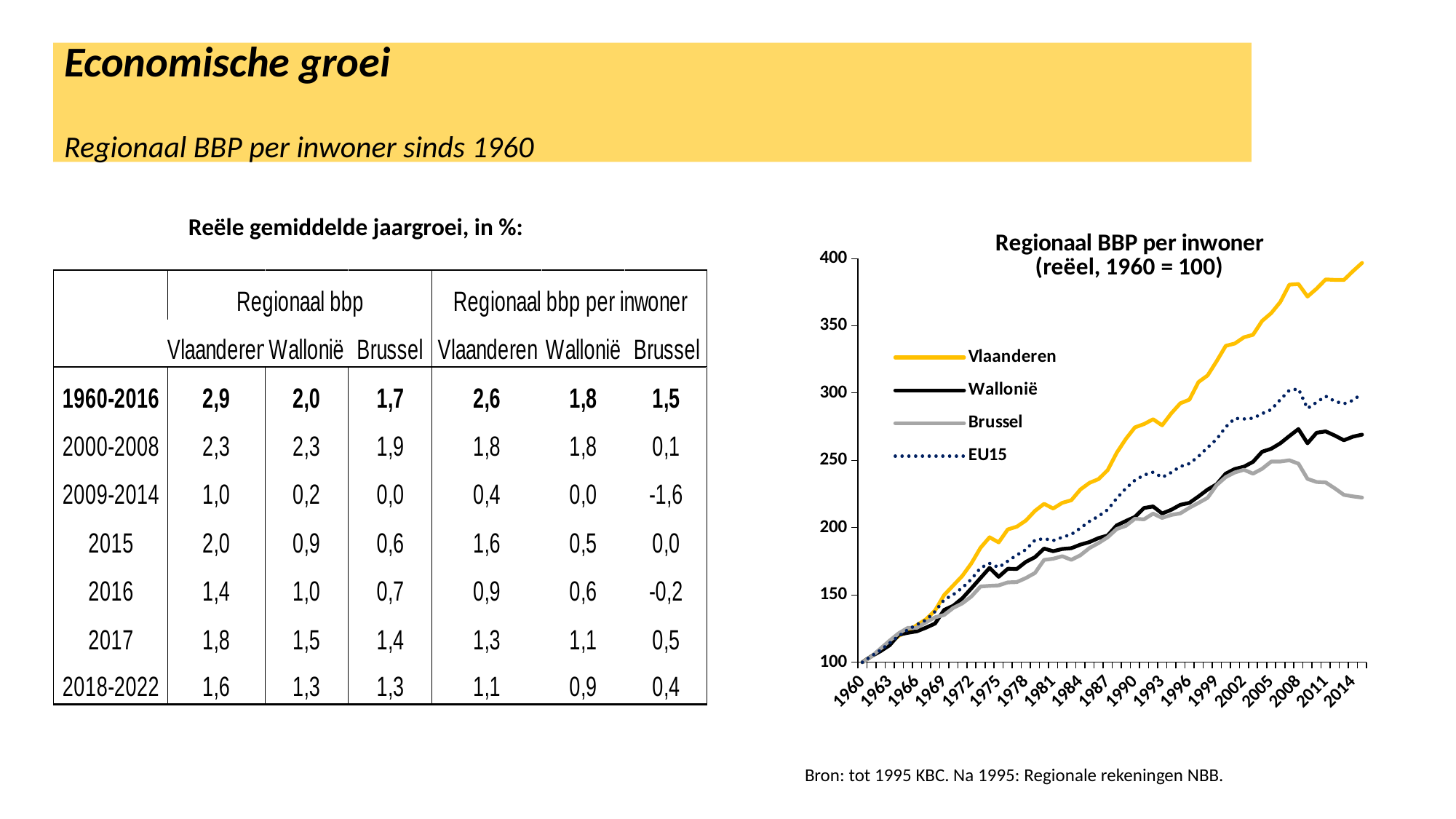
In the 'Regionaal BBP per inwoner' chart, does the Vlaanderen line generally rise or fall from 1960 to the end of the period? rise In the 'Regionaal BBP per inwoner' chart, is the value for Vlaanderen in 1975 greater or less than 200? less In the 'Regionaal BBP per inwoner' chart, is the final value for Vlaanderen greater or less than 350? greater In the 'Regionaal BBP per inwoner' chart, which is higher at the end of the period, Wallonië or Brussel? Wallonië What kind of chart is shown on the right of the slide? line chart In the 'Regionaal BBP per inwoner' chart, which series has the highest value at the end of the period? Vlaanderen How many series does the legend of the 'Regionaal BBP per inwoner' chart list? 4 In the 'Regionaal BBP per inwoner' chart, which series is drawn as a dotted line? EU15 In the 'Regionaal BBP per inwoner' chart, is the final value for Wallonië greater or less than 250? greater In the 'Regionaal BBP per inwoner' chart, which series has the lowest value at the end of the period? Brussel In the 'Regionaal BBP per inwoner' chart, does the Brussel line rise or fall after 2008? fall